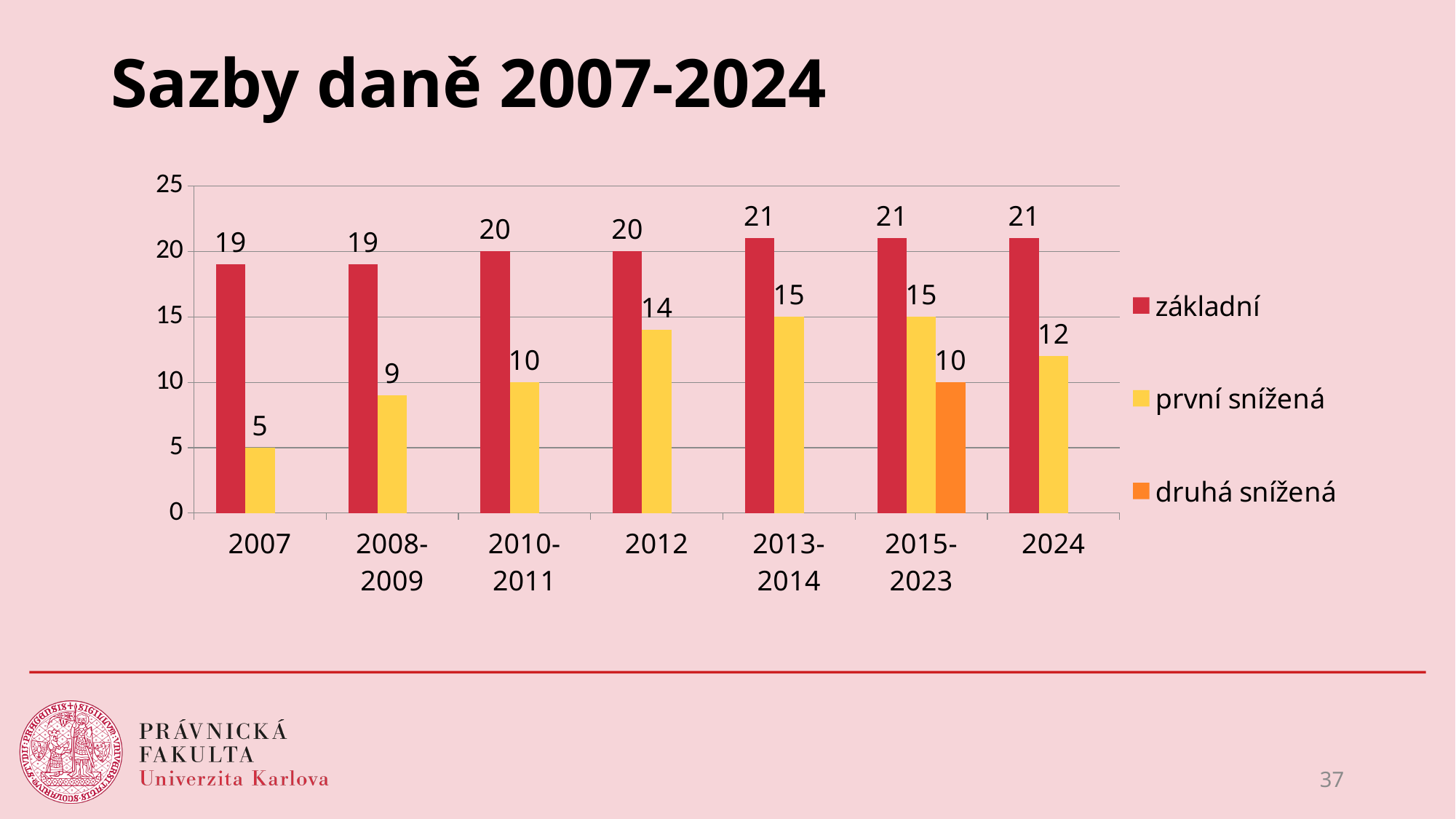
What is the value of the první snížená series for 2012? 14 Does the základní series rise or fall from 2007 to 2024? rise What is the title of the slide containing the chart? Sazby daně 2007-2024 What is the value of the základní series for 2007? 19 What is the value of the druhá snížená series for 2015-2023? 10 Which category has the lowest value for the první snížená series? 2007 How many categories are shown on the x axis? 7 What is the value of the první snížená series for 2024? 12 What is the difference between the základní and první snížená values for 2024? 9 Which is larger: the první snížená value for 2008-2009 or for 2010-2011? 2010-2011 How many series does the legend list? 3 What kind of chart is shown on the slide? bar chart